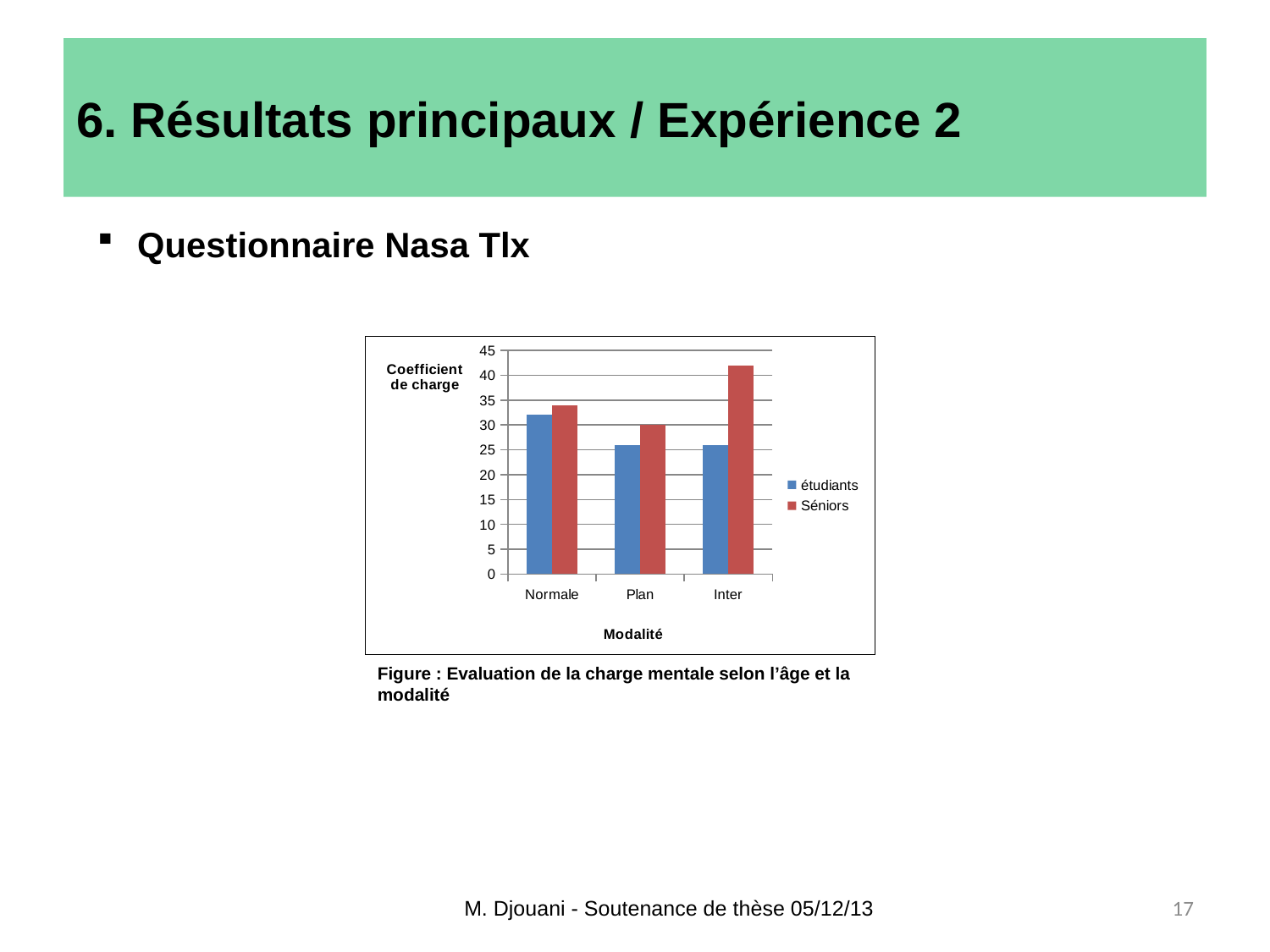
Which category has the highest value for the étudiants series? Normale Which category has the highest value for the Séniors series? Inter How many series does the legend list? 2 What is the label of the x axis? Modalité What kind of chart is shown on the slide? bar chart In the Inter category, which series has the larger value, étudiants or Séniors? Séniors Is the value for étudiants in the Normale category greater or less than 30? greater Which category has the lowest value for the Séniors series? Plan Is the value for Séniors in the Inter category greater or less than 40? greater Is the value for étudiants in the Plan category greater or less than 30? less How many categories are shown on the x axis? 3 Which colour represents the Séniors series? red